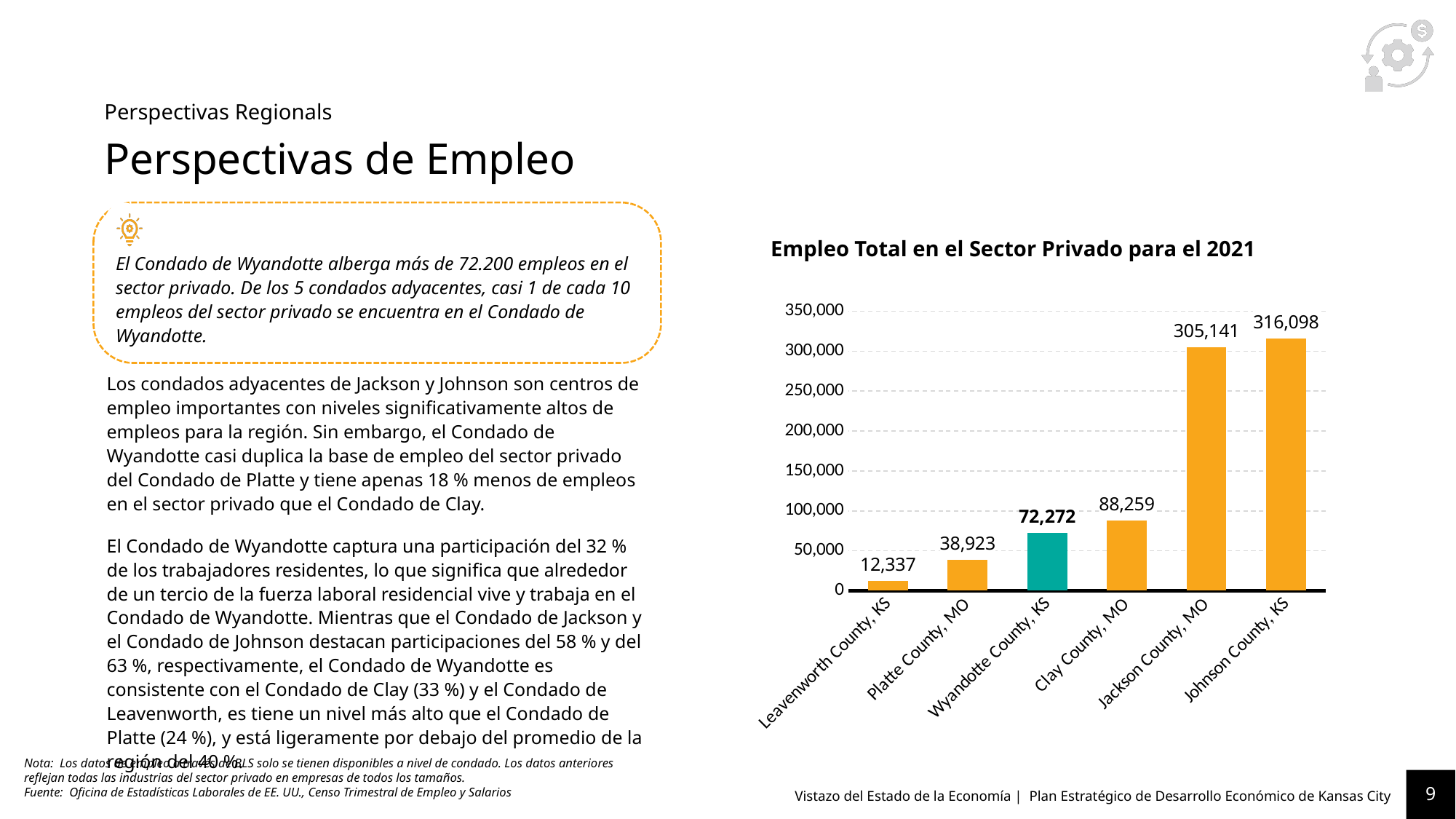
Which county has the lowest total private sector employment? Leavenworth County, KS What is the value for Wyandotte County, KS? 72,272 Which county has the highest total private sector employment? Johnson County, KS What is the value for Leavenworth County, KS? 12,337 What is the value for Jackson County, MO? 305,141 What is the difference between the values for Johnson County, KS and Jackson County, MO? 10,957 What is the difference between the values for Clay County, MO and Wyandotte County, KS? 15,987 Is the value for Jackson County, MO greater or less than 300,000? greater Which is larger, the value for Platte County, MO or the value for Clay County, MO? Clay County, MO What is the title of the chart? Empleo Total en el Sector Privado para el 2021 How many counties are shown in the chart? 6 What kind of chart is shown on the slide? Bar chart